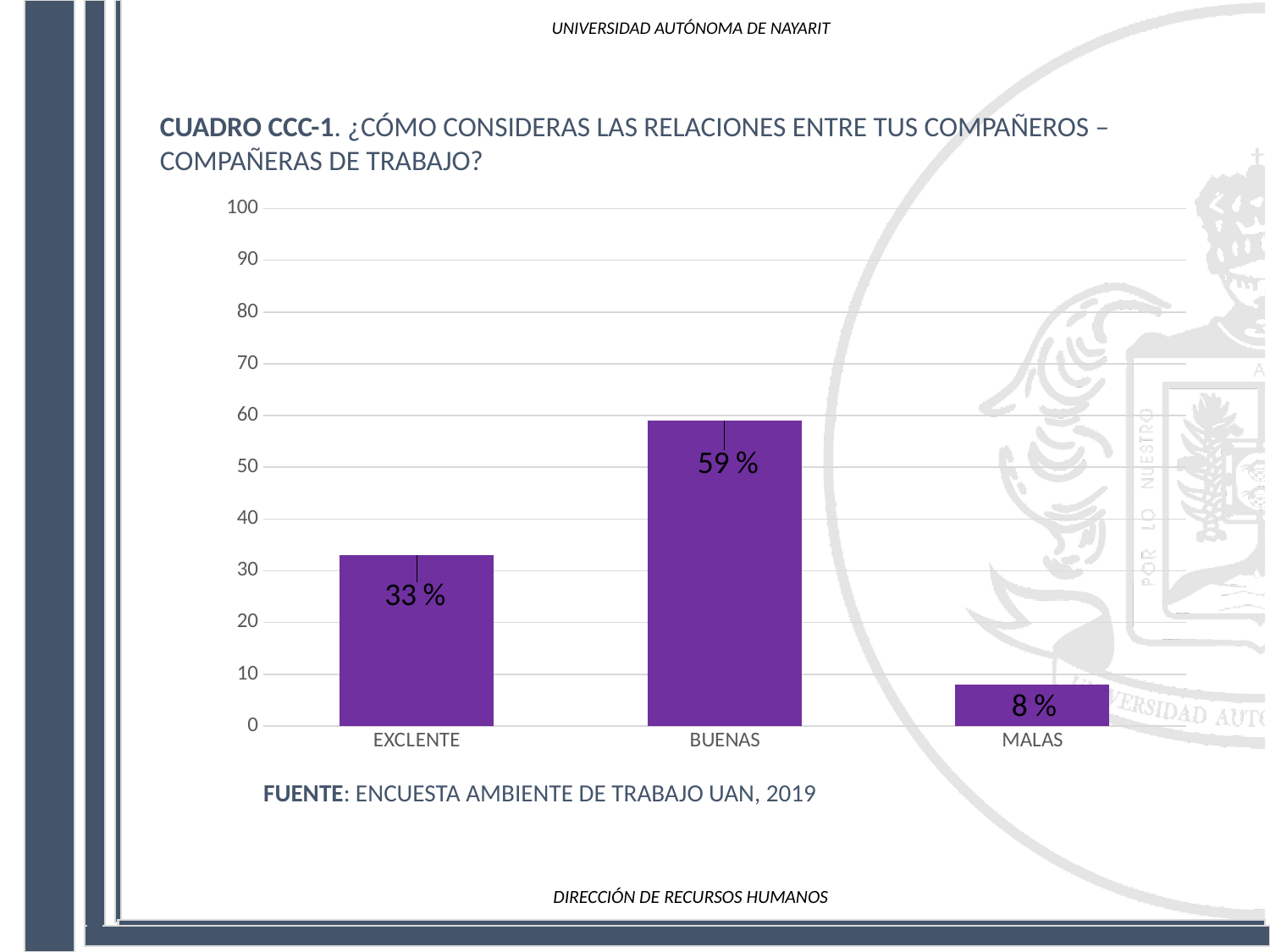
What is the value for BUENAS? 59 % How many categories are shown on the x axis? 3 What kind of chart is shown on the slide? bar chart What source is cited below the chart? ENCUESTA AMBIENTE DE TRABAJO UAN, 2019 What is the value for MALAS? 8 % Which category has the highest value? BUENAS What is the value for EXCLENTE? 33 % Is the value for BUENAS greater or less than 50? greater Which is larger, the value for EXCLENTE or the value for MALAS? EXCLENTE Which category has the lowest value? MALAS What is the difference between the values for EXCLENTE and MALAS? 25 % What is the difference between the values for BUENAS and EXCLENTE? 26 %